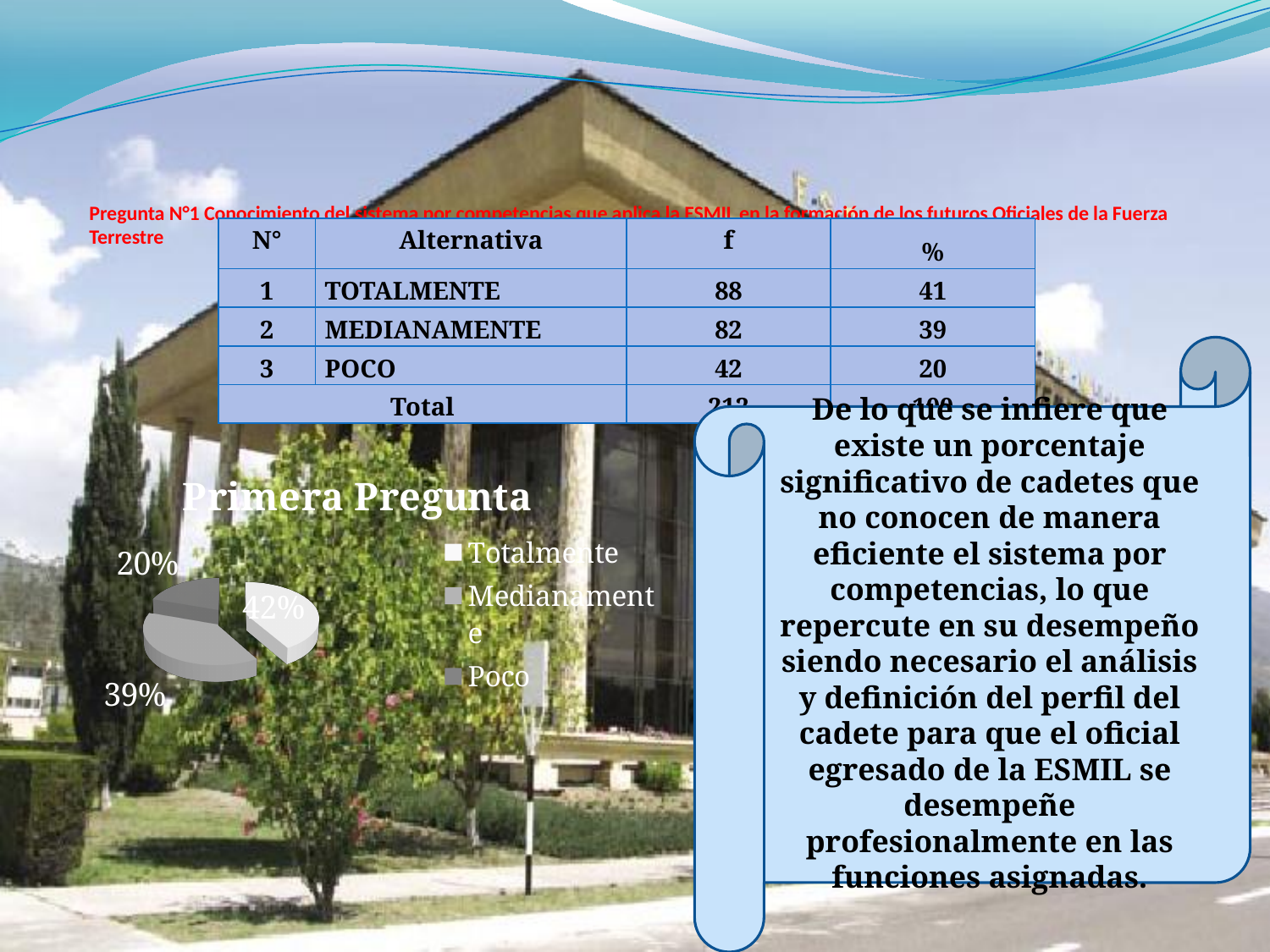
Which is larger in the pie chart, the Totalmente slice or the Poco slice? Totalmente What share of the pie chart does the Totalmente slice represent? 42% How many entries does the legend of the pie chart list? 3 What is the largest percentage shown on the pie chart? 42% What share of the pie chart does the Medianamente slice represent? 39% What are the legend entries of the pie chart? Totalmente, Medianamente, Poco What is the title of the pie chart? Primera Pregunta What is the smallest percentage shown on the pie chart? 20% How many slices does the pie chart have? 3 What is the difference between the 42% slice and the 20% slice in the pie chart? 22% What kind of chart is shown under the heading "Primera Pregunta"? pie chart What share of the pie chart does the Poco slice represent? 20%